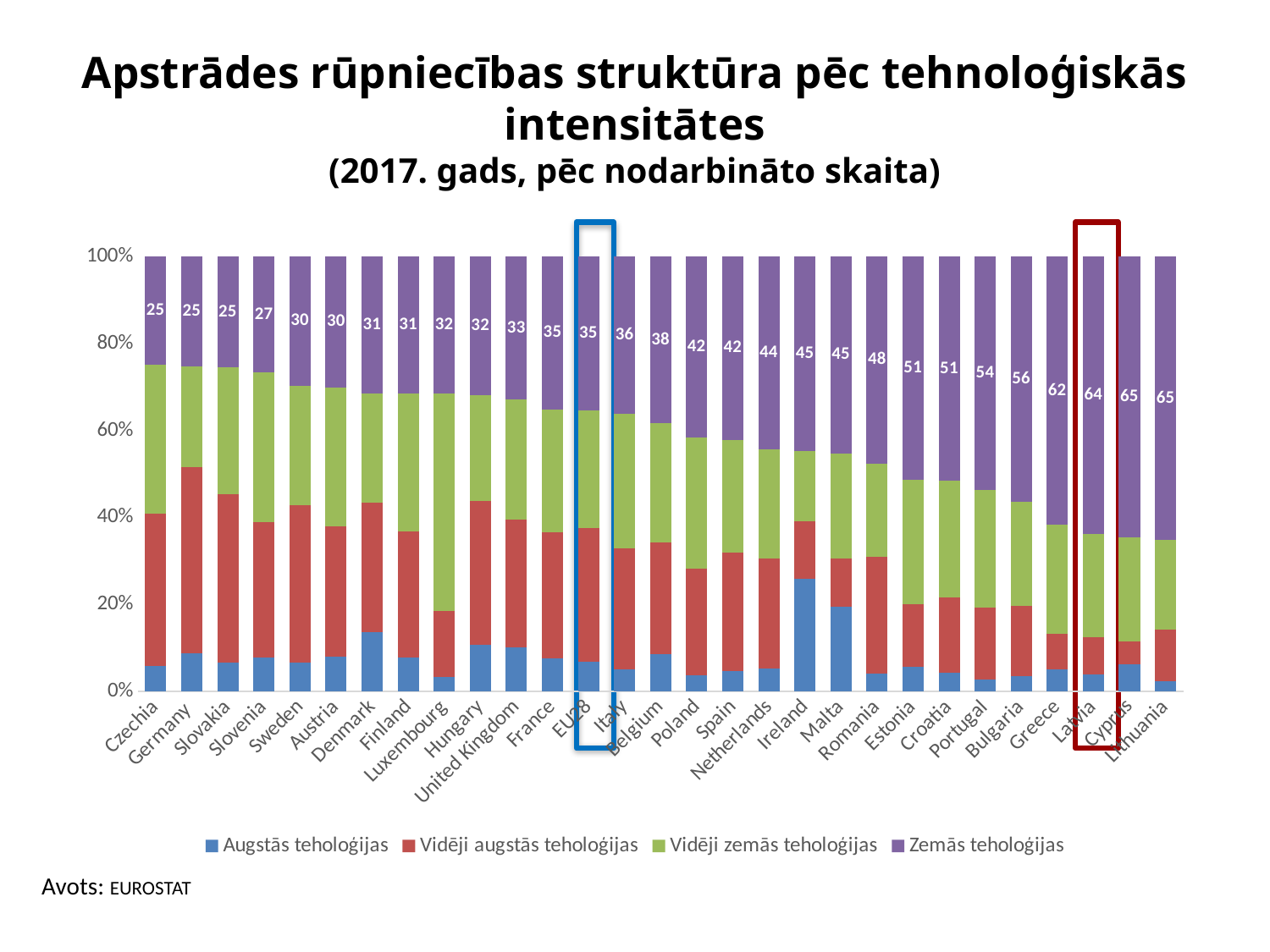
How many countries/categories are shown on the x axis? 29 What is the data label for Czechia in the Zemās tehnoloģijas series? 25 What is the data label for Latvia in the Zemās tehnoloģijas series? 64 What is the difference between the Zemās tehnoloģijas labels for Latvia and EU28? 29 How many series does the legend list? 4 What is the data label for Lithuania in the Zemās tehnoloģijas series? 65 Which has a larger Zemās tehnoloģijas label, Greece or Poland? Greece What kind of chart is shown on the slide? Stacked bar chart What is the data label for EU28 in the Zemās tehnoloģijas series? 35 Is the Augstās tehnoloģijas (blue) segment for Ireland greater or less than 20%? greater Do the Zemās tehnoloģijas data labels rise or fall from left to right along the x axis? Rise Which legend entry is shown in purple? Zemās tehnoloģijas